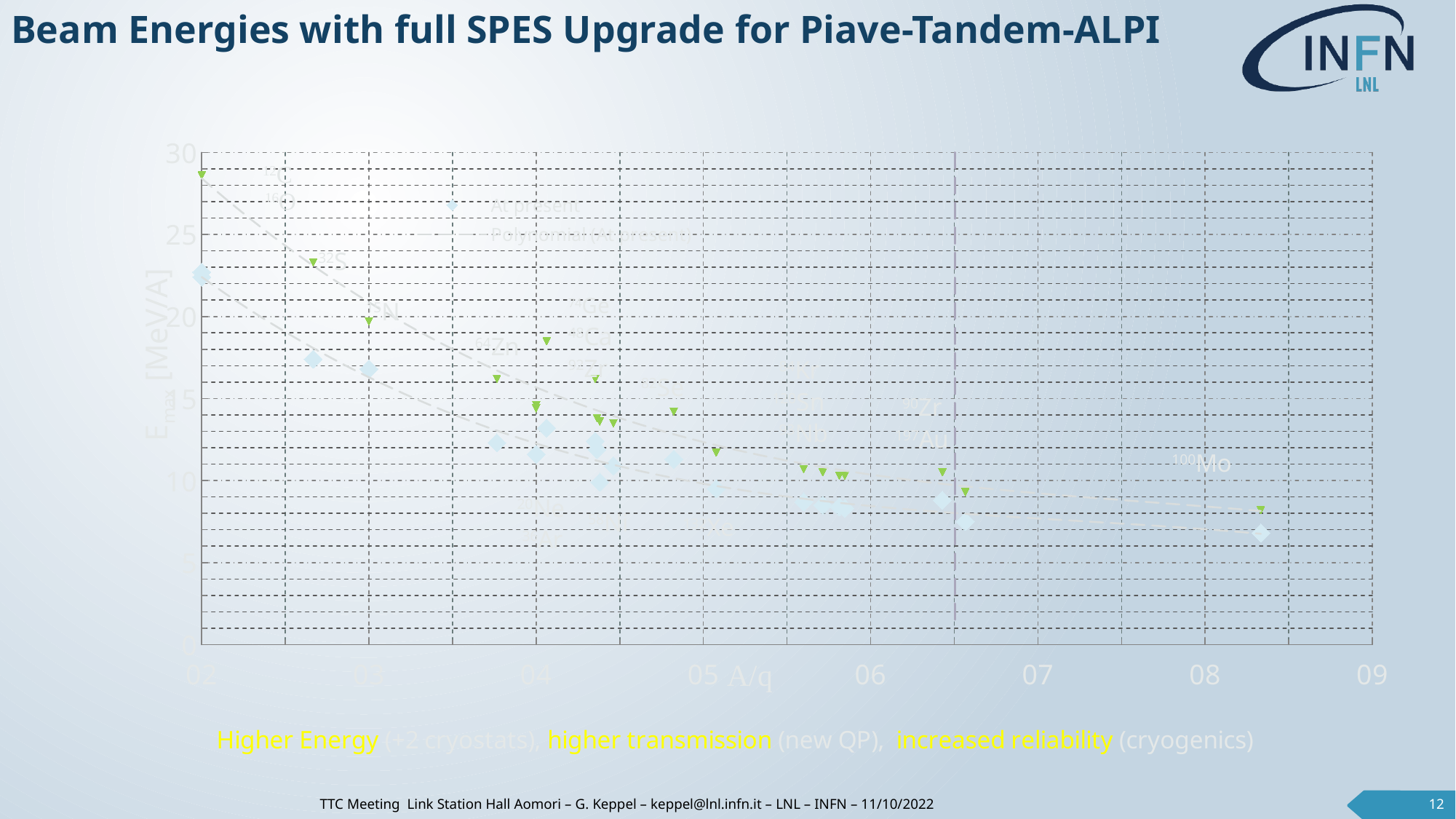
What is the label of the y axis of the chart? Emax [MeV/A] What kind of chart is shown on the slide? scatter chart At A/q = 02, is the green triangle marker higher or lower than the blue diamond marker? higher What is the label of the x axis of the chart? A/q Do the plotted energies generally rise or fall as A/q increases along the x axis? fall Is the value of the green triangle marker at A/q = 02 (the leftmost point) greater or less than 25 MeV/A? greater Is the value of the green triangle marker labelled 32S (near A/q = 03) greater or less than 20 MeV/A? greater Is the value of the green triangle marker labelled 100Mo (near A/q = 08) greater or less than 10 MeV/A? less What is the highest value shown on the y axis of the chart? 30